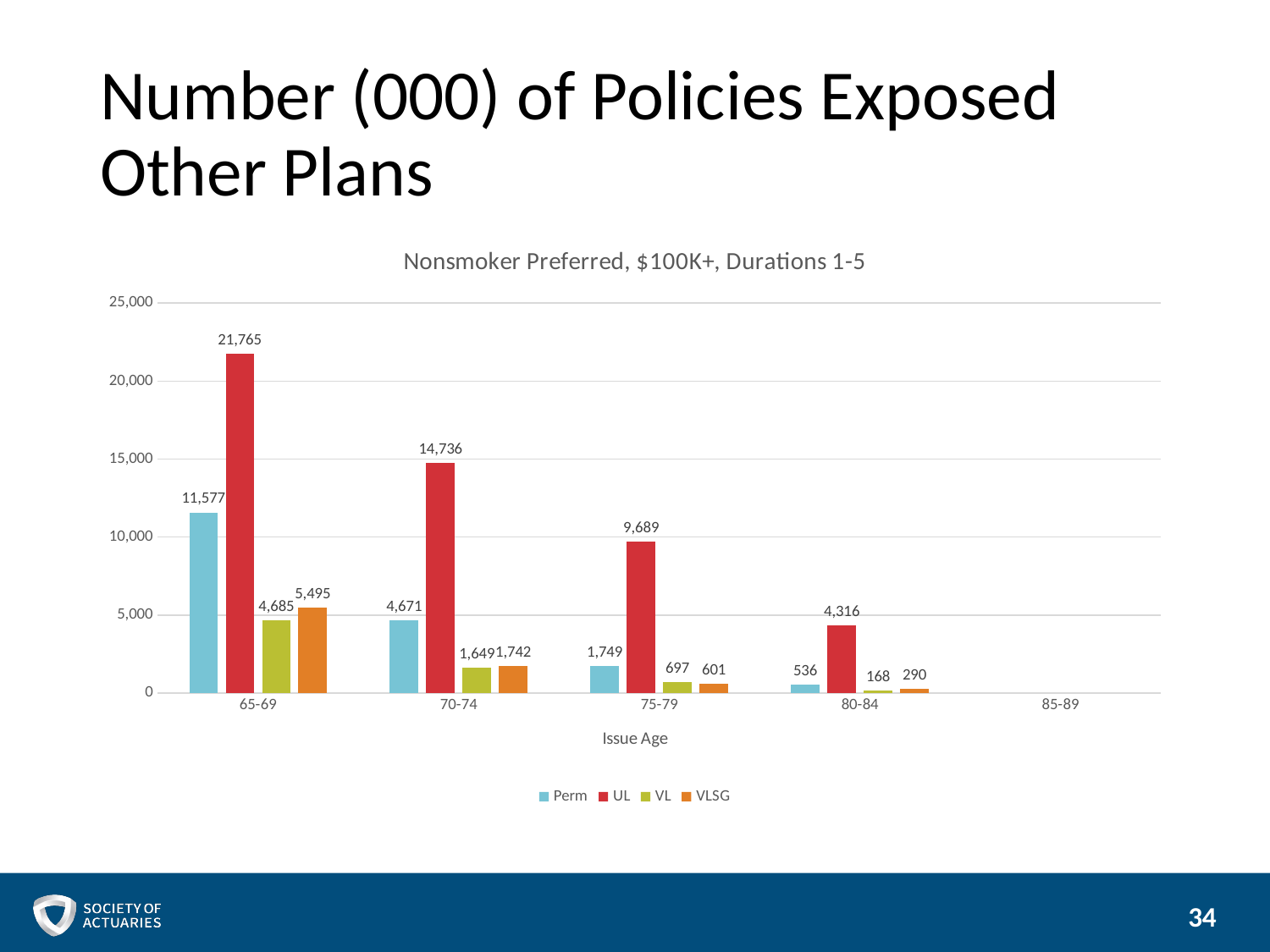
Which series has the lowest value at issue age 80-84? VL What is the title of the chart? Nonsmoker Preferred, $100K+, Durations 1-5 How many series does the legend list? 4 What type of chart is shown on the slide? Bar chart Which issue age group has the highest UL value? 65-69 What is the value for Perm at issue age 70-74? 4,671 Do the UL values rise or fall as issue age increases from 65-69 to 80-84? Fall At issue age 70-74, which is larger: VL or VLSG? VLSG What is the difference between the UL and Perm values at issue age 65-69? 10,188 What is the value for VLSG at issue age 80-84? 290 What is the value for VL at issue age 75-79? 697 What is the value for UL at issue age 65-69? 21,765